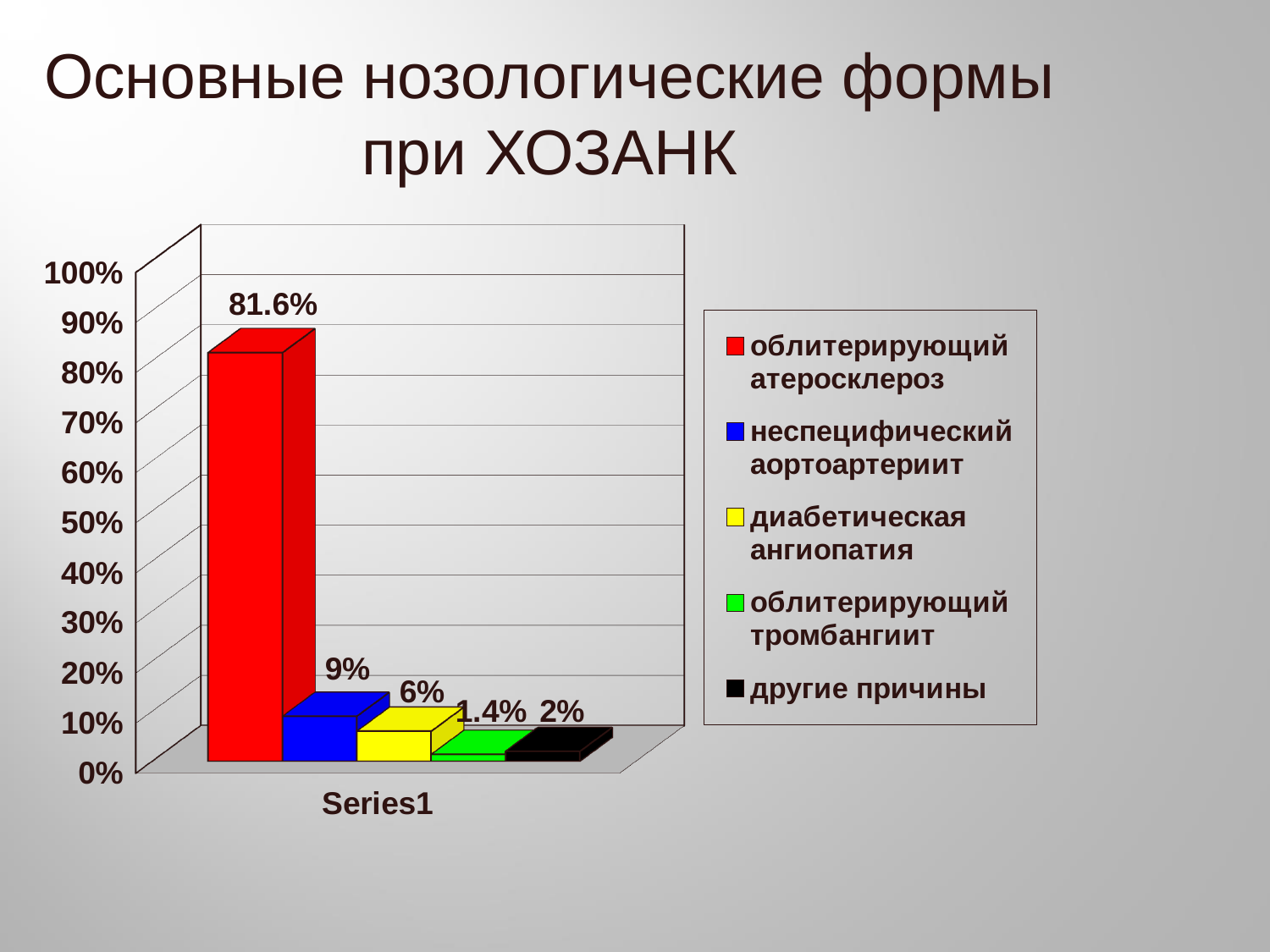
What is the value for облитерирующий атеросклероз? 81.6% What is the difference between the values for облитерирующий атеросклероз and неспецифический аортоартериит? 72.6% Which nosological form has the lowest value? облитерирующий тромбангиит How many series does the legend list? 5 What colour is the bar for неспецифический аортоартериит? blue What is the value for диабетическая ангиопатия? 6% What is the value for неспецифический аортоартериит? 9% What is the value for облитерирующий тромбангиит? 1.4% What is the value for другие причины? 2% What kind of chart is shown on the slide? bar chart Which is larger, the value for диабетическая ангиопатия or the value for другие причины? диабетическая ангиопатия Which nosological form has the highest value? облитерирующий атеросклероз